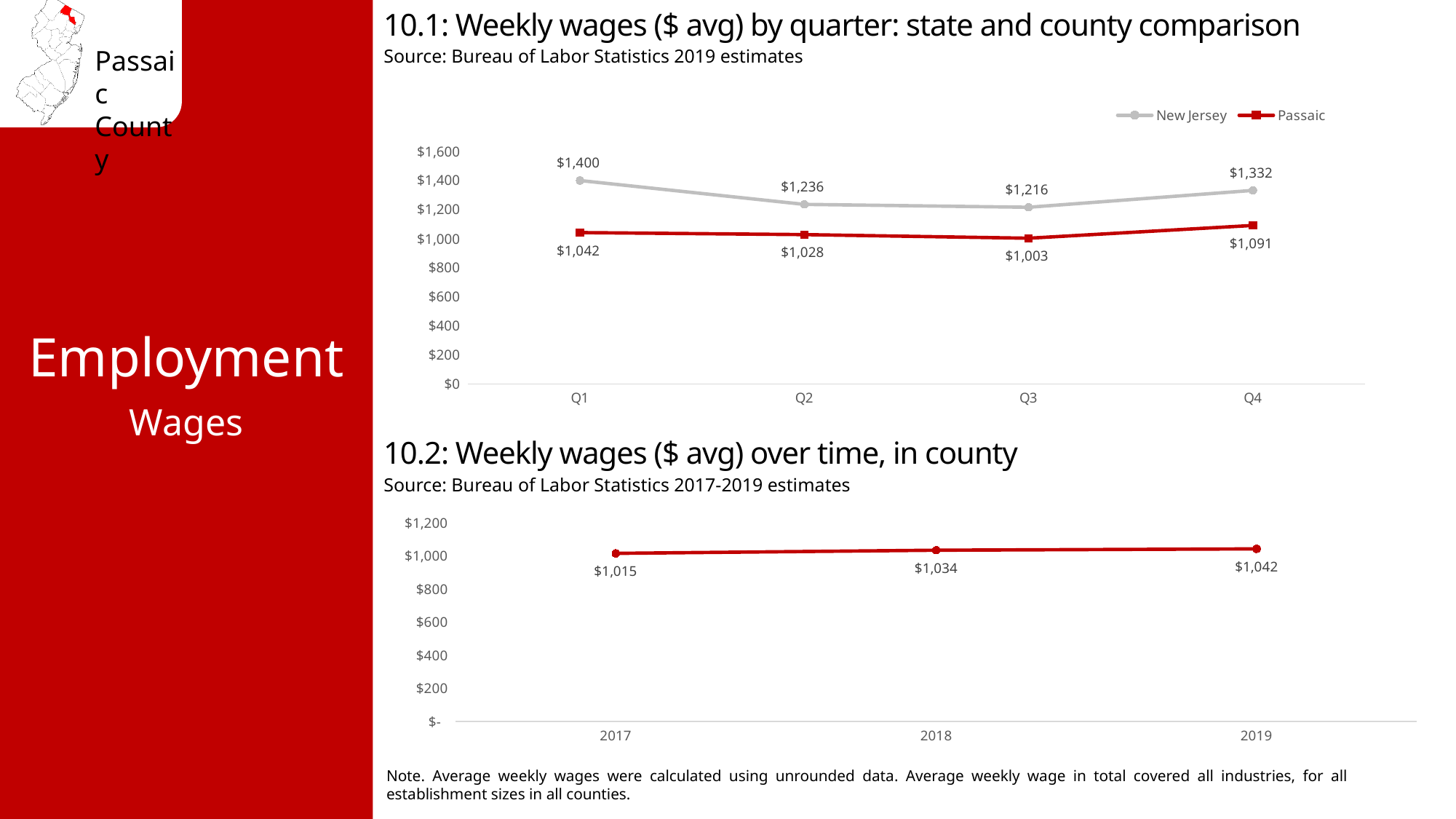
In chart 10.1 (weekly wages by quarter), what is the New Jersey value for Q1? $1,400 In chart 10.1 (weekly wages by quarter), what is the difference between the New Jersey and Passaic values in Q4? $241 In chart 10.1 (weekly wages by quarter), how many series does the legend list? 2 In chart 10.1 (weekly wages by quarter), which quarter has the lowest New Jersey value? Q3 In chart 10.2 (weekly wages over time), how many years are plotted? 3 In chart 10.1 (weekly wages by quarter), which quarter has the highest Passaic value? Q4 In chart 10.1 (weekly wages by quarter), what kind of chart is shown? Line chart In chart 10.1 (weekly wages by quarter), what is the Passaic value for Q3? $1,003 In chart 10.1 (weekly wages by quarter), which series has the larger value in Q2, New Jersey or Passaic? New Jersey In chart 10.2 (weekly wages over time), what is the difference between the 2019 and 2017 values? $27 In chart 10.2 (weekly wages over time), what is the value for 2018? $1,034 In chart 10.2 (weekly wages over time), do the values rise or fall from 2017 to 2019? Rise